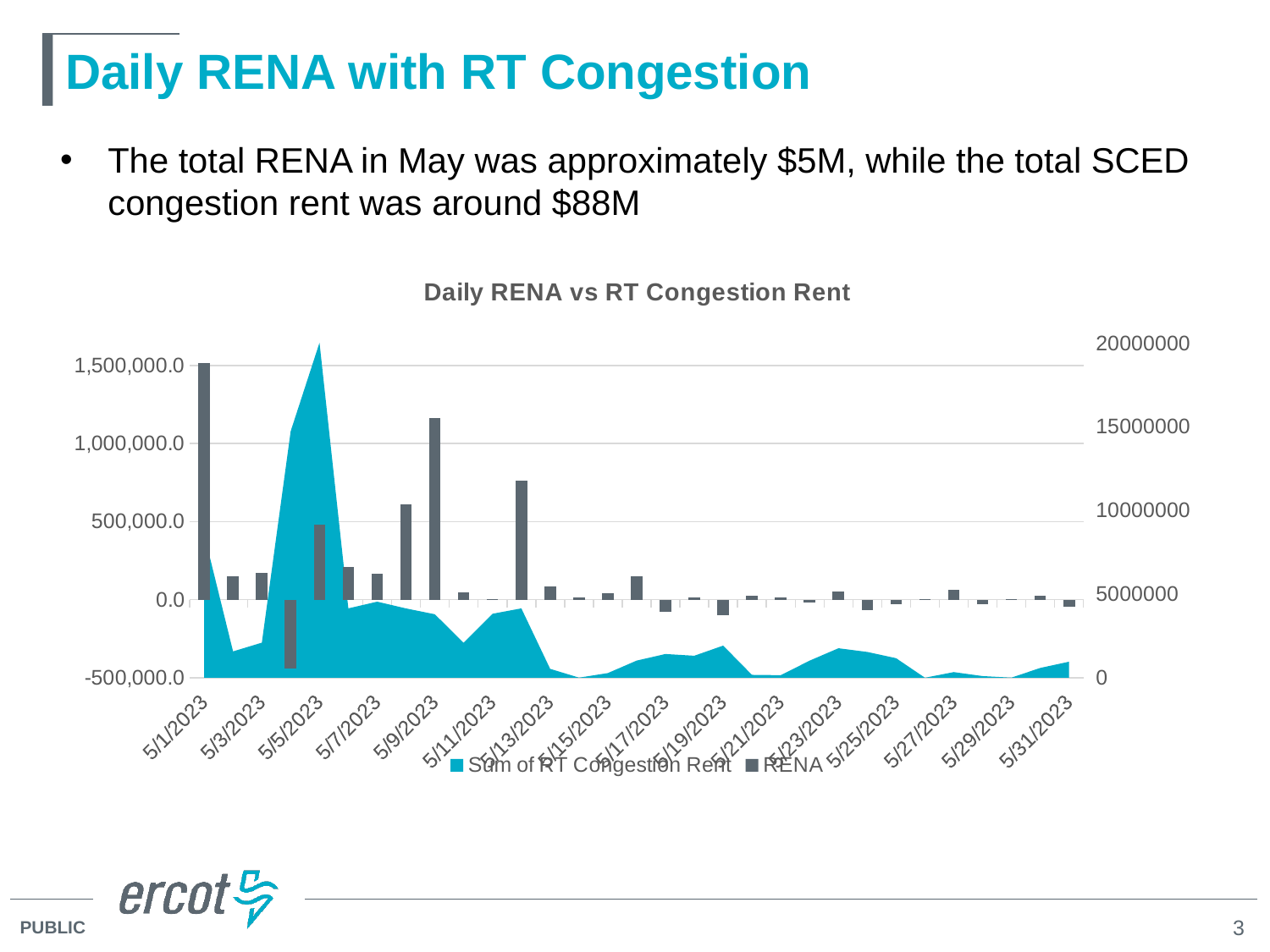
Is the RENA value for 5/9/2023 greater or less than 1,000,000.0? greater Is the RENA value for 5/1/2023 greater or less than 1,000,000.0? greater On which date does the Sum of RT Congestion Rent reach its peak? 5/5/2023 How many series does the legend list? 2 Is the Sum of RT Congestion Rent for 5/5/2023 greater or less than 15000000? greater On which date is the RENA bar highest? 5/1/2023 What are the two series named in the legend? Sum of RT Congestion Rent and RENA What kind of chart is shown on the slide? A combination chart with an area series and a bar series Which date has the larger Sum of RT Congestion Rent, 5/5/2023 or 5/9/2023? 5/5/2023 What is the title of the chart? Daily RENA vs RT Congestion Rent Which date has the larger RENA value, 5/1/2023 or 5/9/2023? 5/1/2023